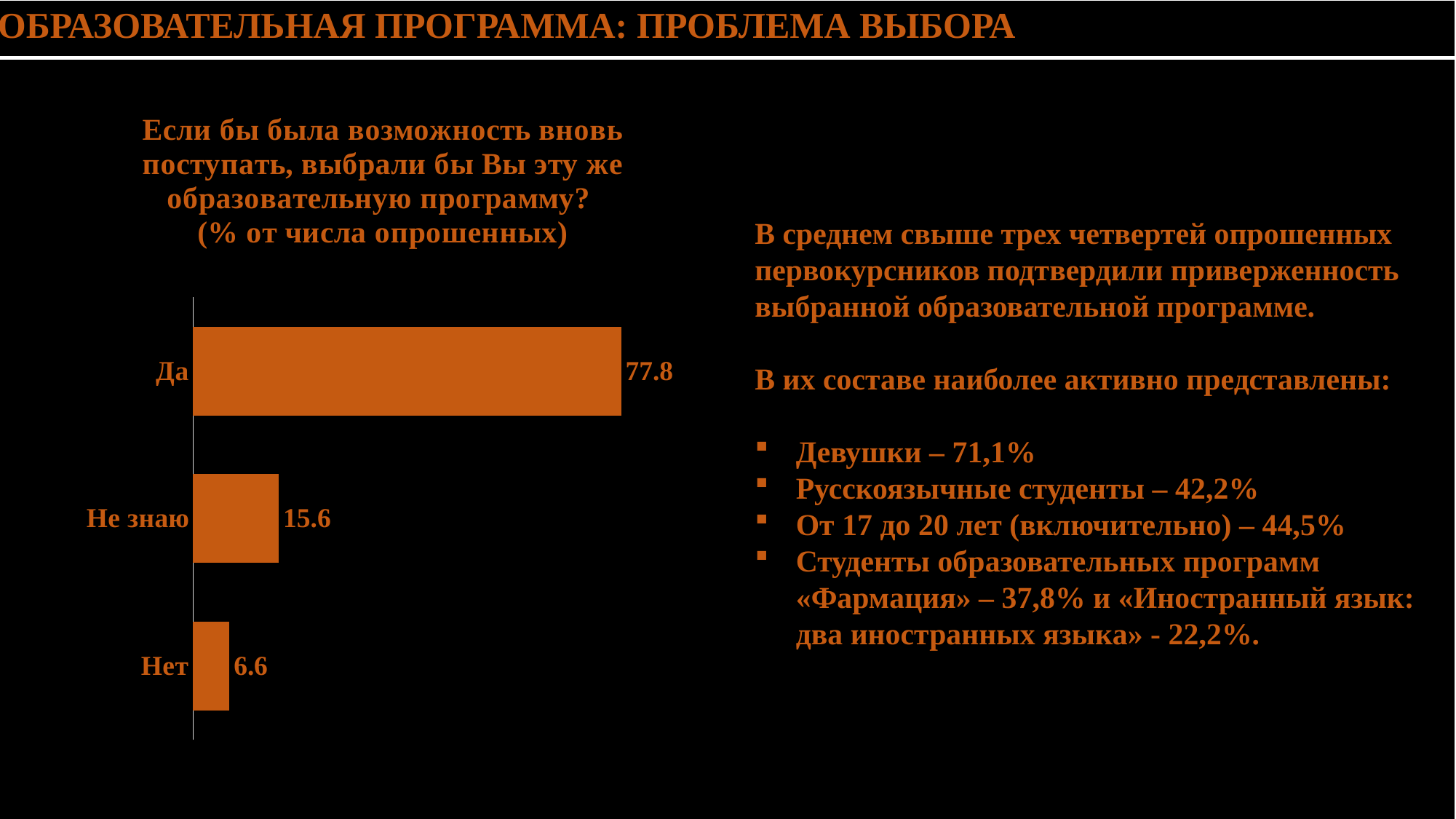
Which category has the lowest value in the chart? Нет What is the total of the three values shown in the chart? 100.0 What is the difference between the values for "Да" and "Не знаю"? 62.2 What is the value for "Да" in the chart? 77.8 Which category has the highest value in the chart? Да What is the difference between the values for "Не знаю" and "Нет"? 9.0 What colour are the bars in the chart? Orange Which is larger, the value for "Не знаю" or the value for "Нет"? Не знаю What is the value for "Нет" in the chart? 6.6 What kind of chart is shown on the slide? Bar chart What is the value for "Не знаю" in the chart? 15.6 How many categories are shown in the chart? 3